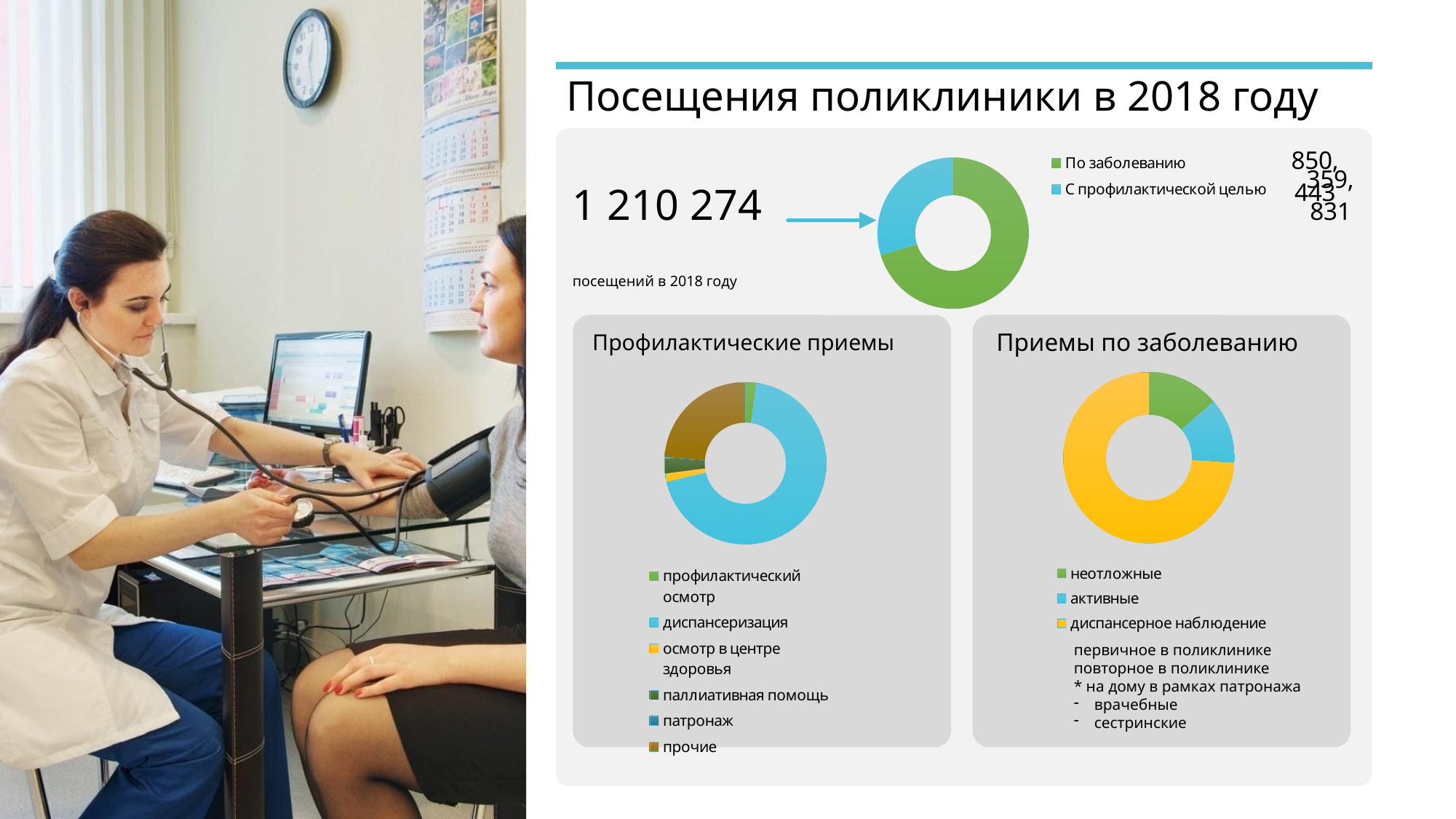
In the Приемы по заболеванию chart, which category has the largest share? диспансерное наблюдение In the Приемы по заболеванию chart, which is larger: диспансерное наблюдение or активные? диспансерное наблюдение In the top chart, which colour represents С профилактической целью? blue In the top chart, which category is larger: По заболеванию or С профилактической целью? По заболеванию What kind of chart is shown under the heading Профилактические приемы? doughnut chart How many series does the legend of the top chart list? 2 In the Профилактические приемы chart, which is larger: диспансеризация or прочие? диспансеризация In the Профилактические приемы chart, which category has the largest share? диспансеризация How many categories does the legend of the Приемы по заболеванию chart list? 3 What kind of chart is shown under the heading Приемы по заболеванию? doughnut chart What kind of chart is the top chart next to the number 1 210 274? doughnut chart How many categories does the legend of the Профилактические приемы chart list? 6